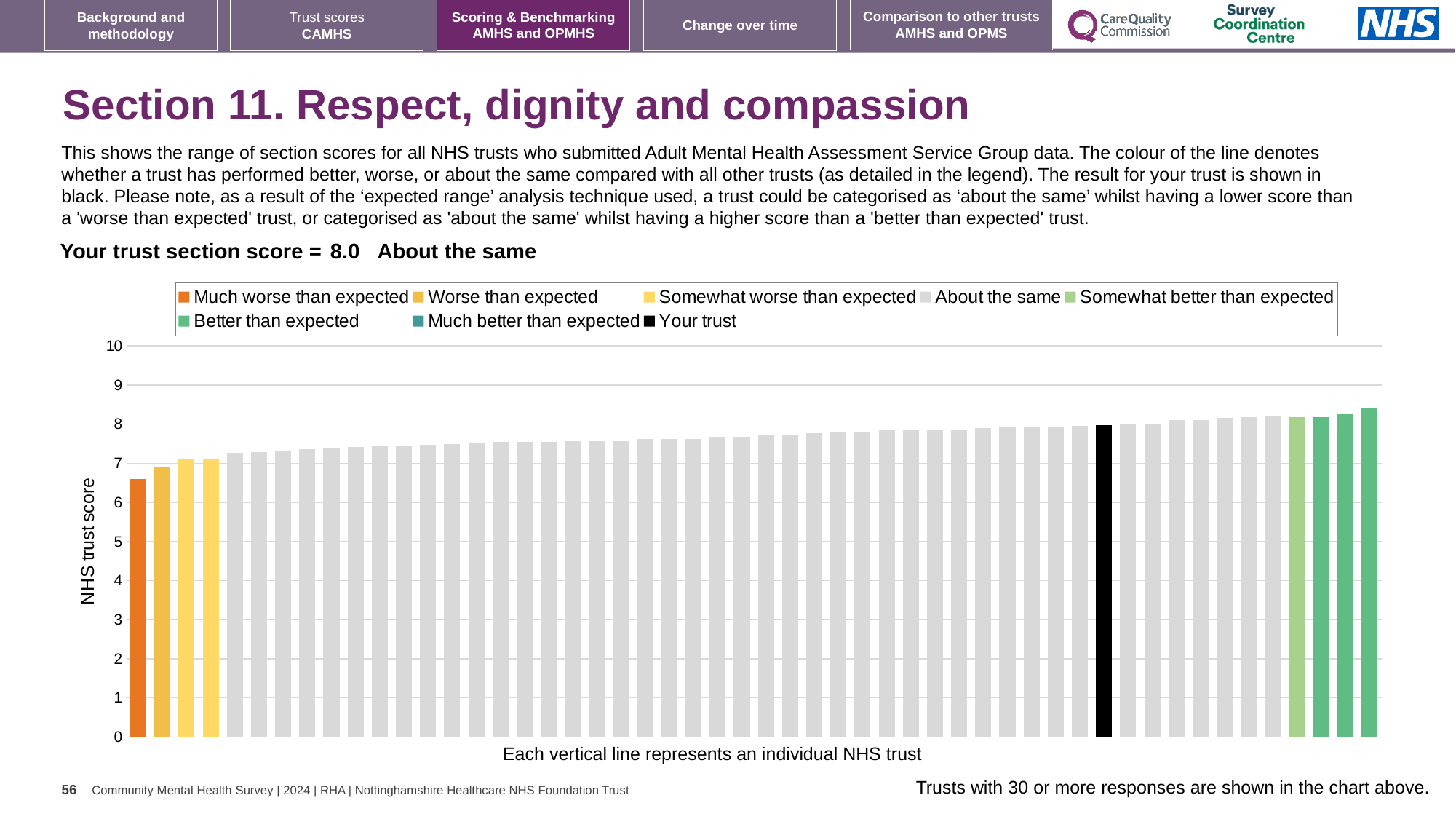
Is the value of the highest bar on the chart greater or less than 8? greater Is the value of the lowest bar (the 'Much worse than expected' trust) greater or less than 7? less Which category is your trust placed in for this section? About the same Which legend category does the highest bar on the chart belong to? Better than expected What is the section score for your trust? 8.0 Is the value of the 'Your trust' bar greater or less than 9? less How many entries does the chart legend list? 8 Is the 'Your trust' bar higher or lower than the 'Much worse than expected' bar? higher What kind of chart is shown on the slide? bar chart What is the label on the vertical axis of the chart? NHS trust score Do the bar values rise or fall from left to right along the x axis? rise Which legend category does the lowest bar on the chart belong to? Much worse than expected